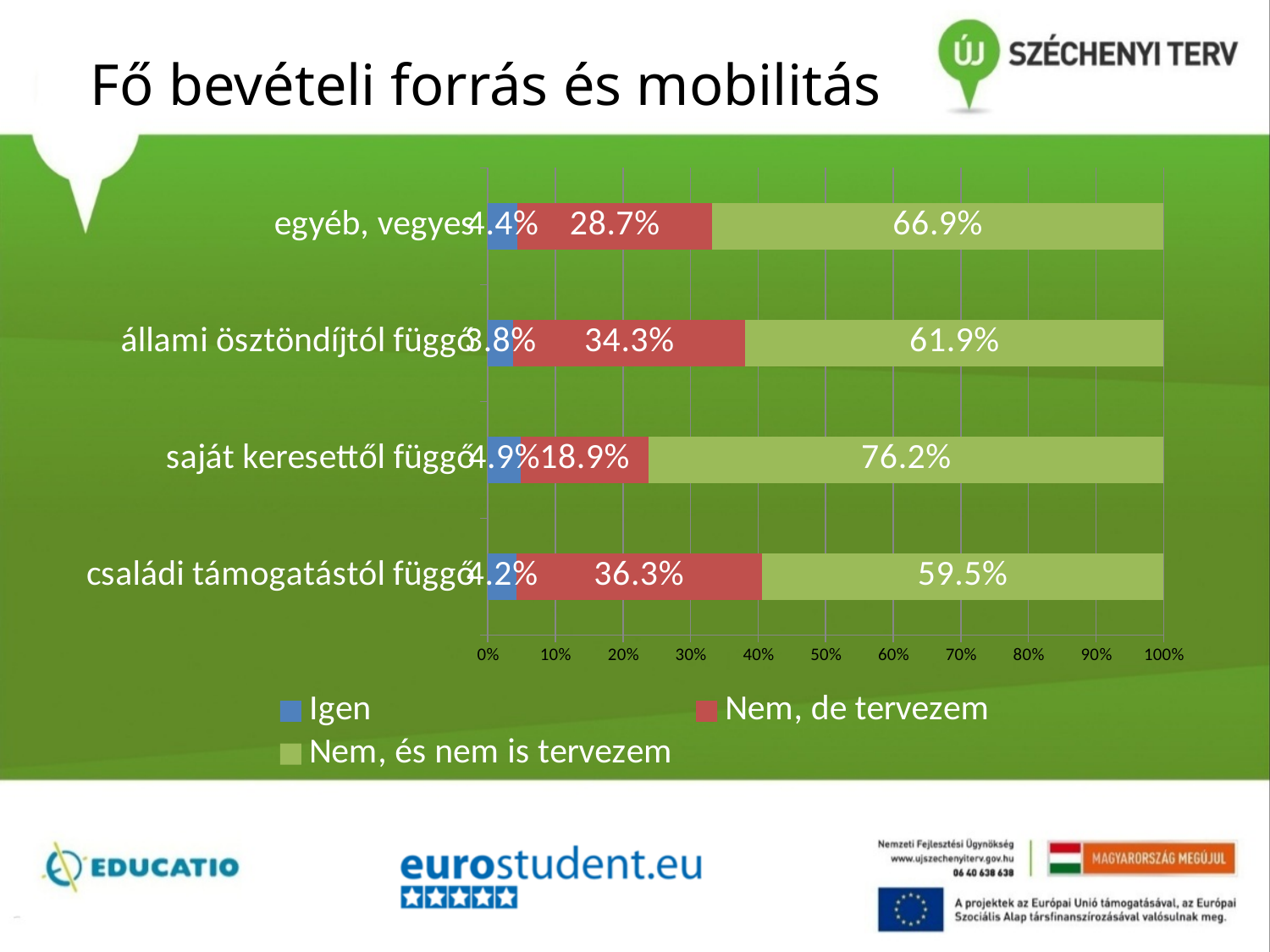
Which category has the lowest value for "Nem, de tervezem"? saját keresettől függő What kind of chart is shown on the slide? stacked bar chart What is the value of "Nem, de tervezem" for "egyéb, vegyes"? 28.7% What is the value of "Nem, és nem is tervezem" for "saját keresettől függő"? 76.2% What is the difference between the "Nem, de tervezem" values for "családi támogatástól függő" and "egyéb, vegyes"? 7.6% Which category has the highest value for "Nem, és nem is tervezem"? saját keresettől függő What is the title of the slide containing the chart? Fő bevételi forrás és mobilitás How many categories are shown on the chart? 4 What is the value of "Nem, de tervezem" for "családi támogatástól függő"? 36.3% How many series does the legend list? 3 Which is larger: the "Nem, és nem is tervezem" value for "egyéb, vegyes" or for "családi támogatástól függő"? egyéb, vegyes What is the value of "Nem, és nem is tervezem" for "állami ösztöndíjtól függő"? 61.9%